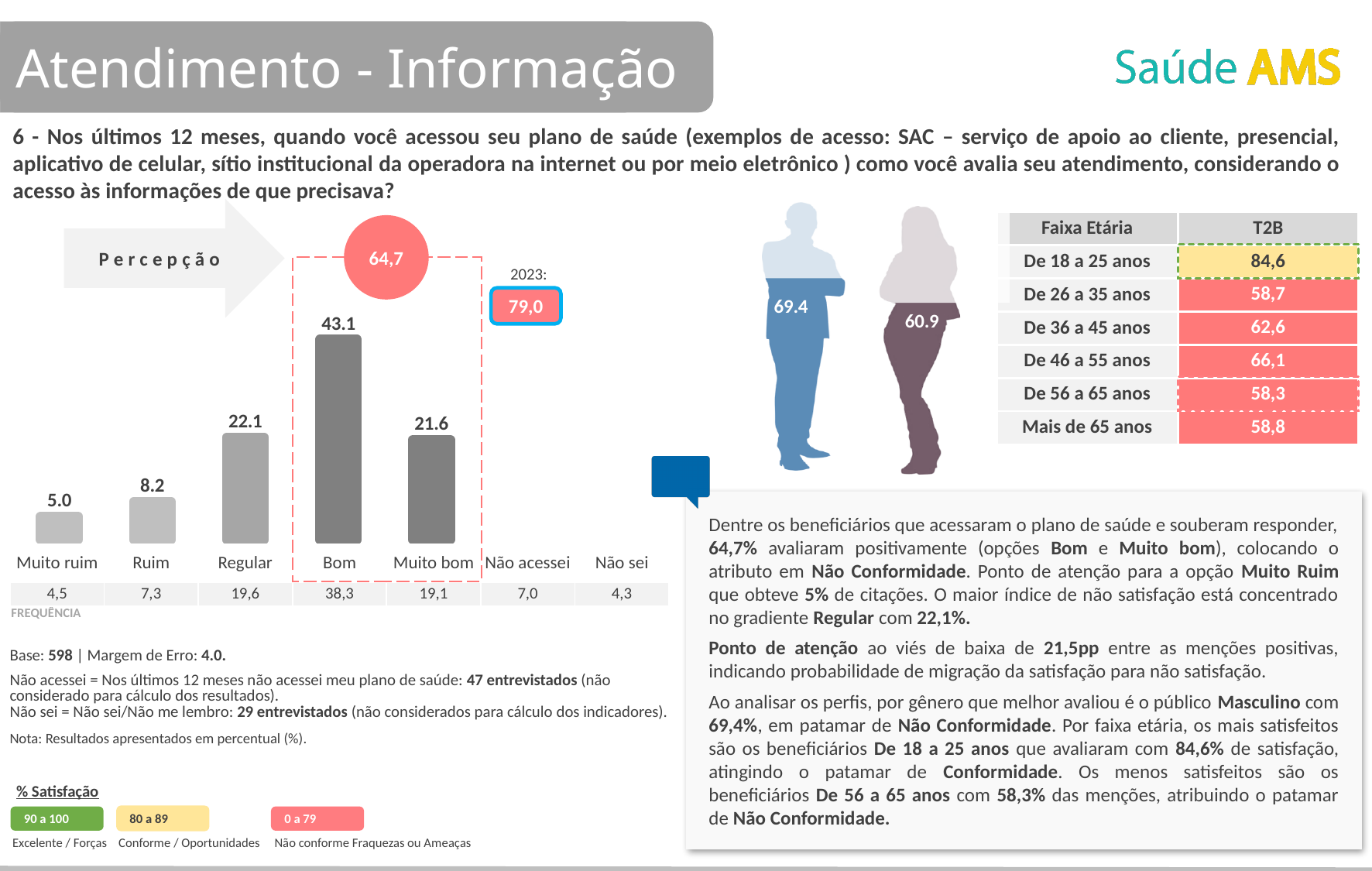
Which category has the highest bar in the chart? Bom What value is shown in the box labelled '2023:' next to the chart? 79,0 What combined value is shown in the red circle above the 'Bom' and 'Muito bom' bars? 64,7 What is the difference between the values for 'Bom' and 'Muito bom'? 21.5 What is the value shown for the 'Muito bom' bar? 21.6 What is the difference between the values for 'Ruim' and 'Muito ruim'? 3.2 What is the value shown for the 'Regular' bar? 22.1 What is the value shown for the 'Muito ruim' bar? 5.0 Which category has the lowest bar among those with plotted values? Muito ruim What type of chart is used to show the evaluation of service information access? bar chart What is the value shown for the 'Bom' bar? 43.1 Which is larger, the value for 'Regular' or the value for 'Ruim'? Regular